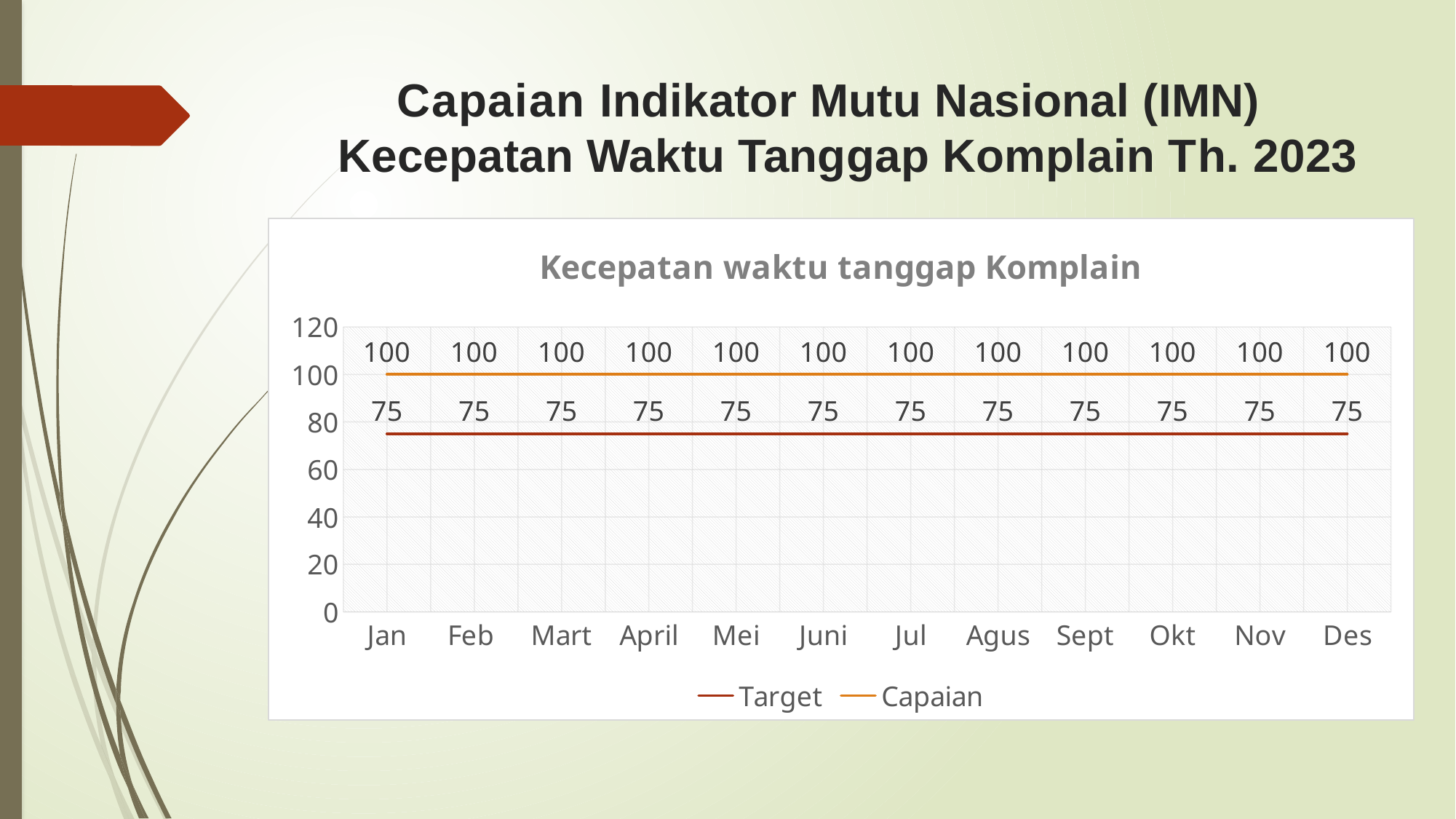
How many series does the legend list? 2 Is the Target value for April greater or less than 80? less What is the Capaian value for Jan? 100 What is the Capaian value for Juni? 100 Which series has the higher value in Sept, Target or Capaian? Capaian Does the Capaian series rise, fall, or stay flat from Jan to Des? stays flat What is the Target value for Des? 75 What is the title of the chart? Kecepatan waktu tanggap Komplain How many months are shown on the x axis? 12 What kind of chart is shown? line chart Which series is drawn in orange? Capaian What is the difference between Capaian and Target in Mart? 25